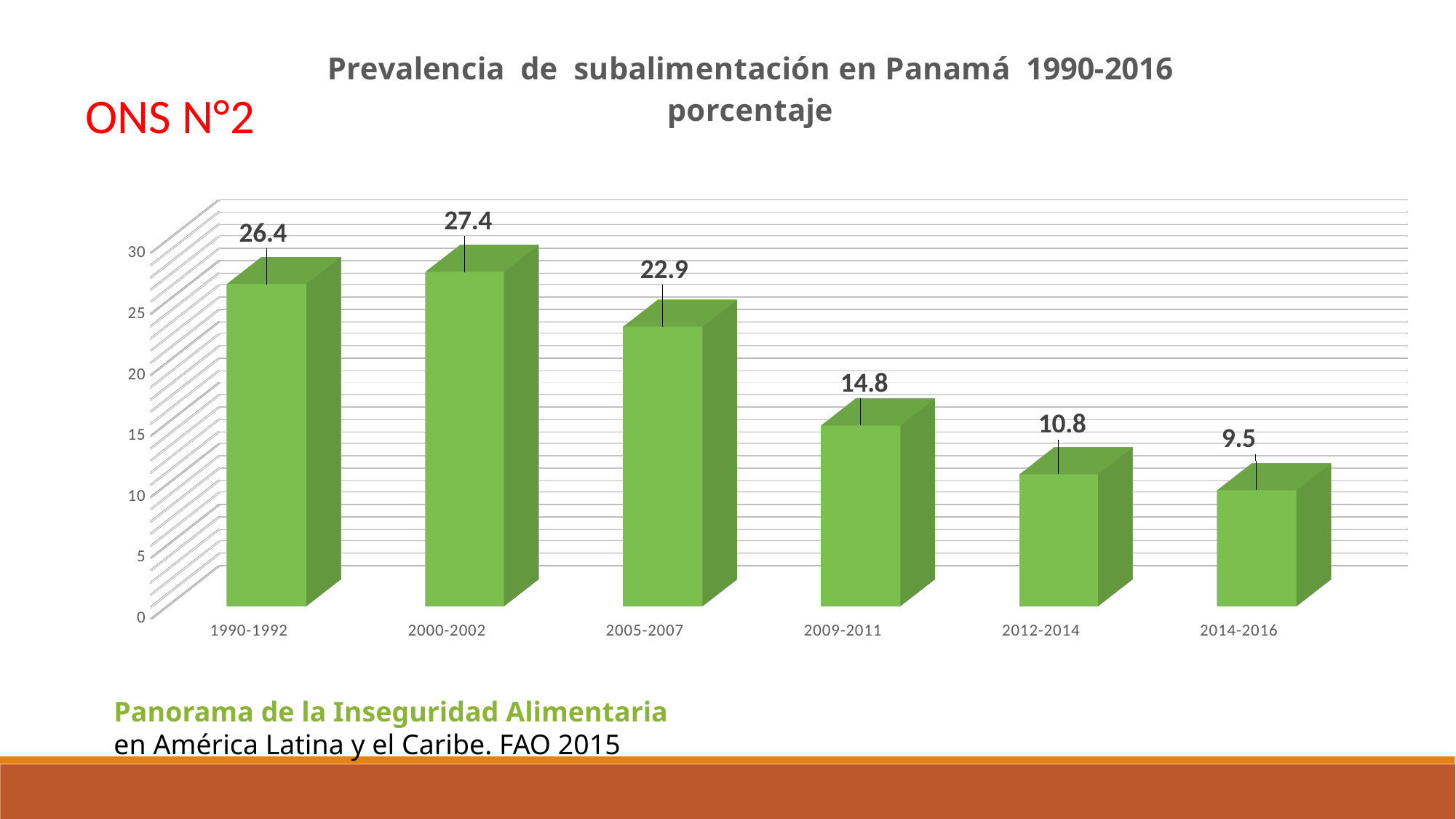
What is the difference between the values for 1990-1992 and 2014-2016? 16.9 How many periods are shown on the x axis? 6 What is the difference between the values for 2000-2002 and 2005-2007? 4.5 What is the value for 2009-2011? 14.8 What is the value for 2014-2016? 9.5 Which period has the highest value? 2000-2002 Which is larger, the value for 2005-2007 or the value for 2012-2014? 2005-2007 Is the value for 2012-2014 greater or less than 15? less What is the value for 1990-1992? 26.4 Do the values rise or fall from 2000-2002 to 2014-2016? fall What kind of chart is this? bar chart Which period has the lowest value? 2014-2016